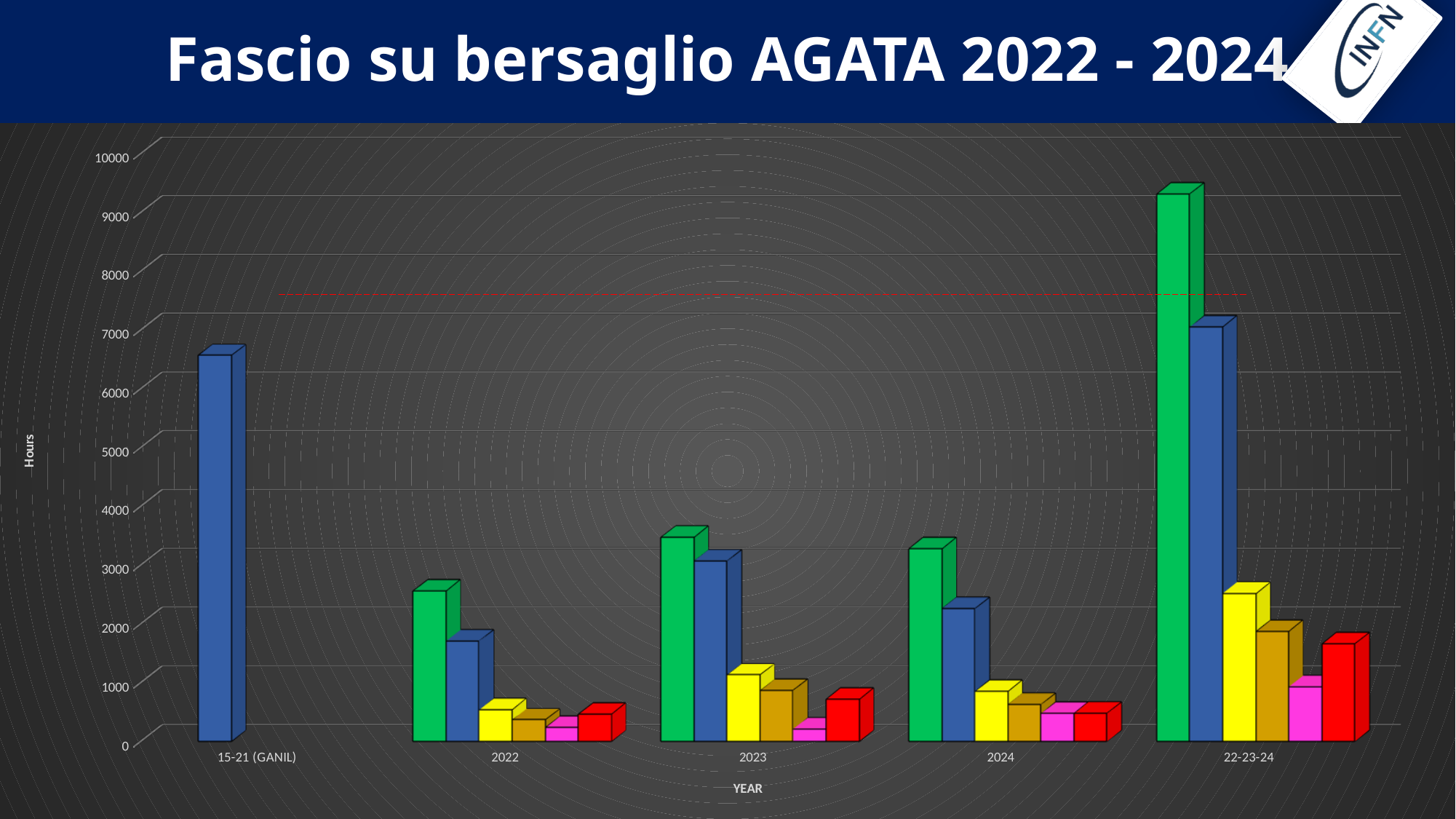
Which is larger, the blue bar for 2023 or the blue bar for 2024? the blue bar for 2023 What is the label of the vertical axis of the chart? Hours Is the value of the green bar for 22-23-24 greater or less than 9000? greater Is the value of the red bar for 22-23-24 greater or less than 2000? less What is the title of the slide containing the chart? Fascio su bersaglio AGATA 2022 - 2024 What kind of chart is shown on the slide? bar chart Is the value of the blue bar for 15-21 (GANIL) greater or less than 6000? greater Which category contains the tallest bar in the chart? 22-23-24 How many bars are shown for the 2022 category? 6 How many categories are shown on the x axis of the chart? 5